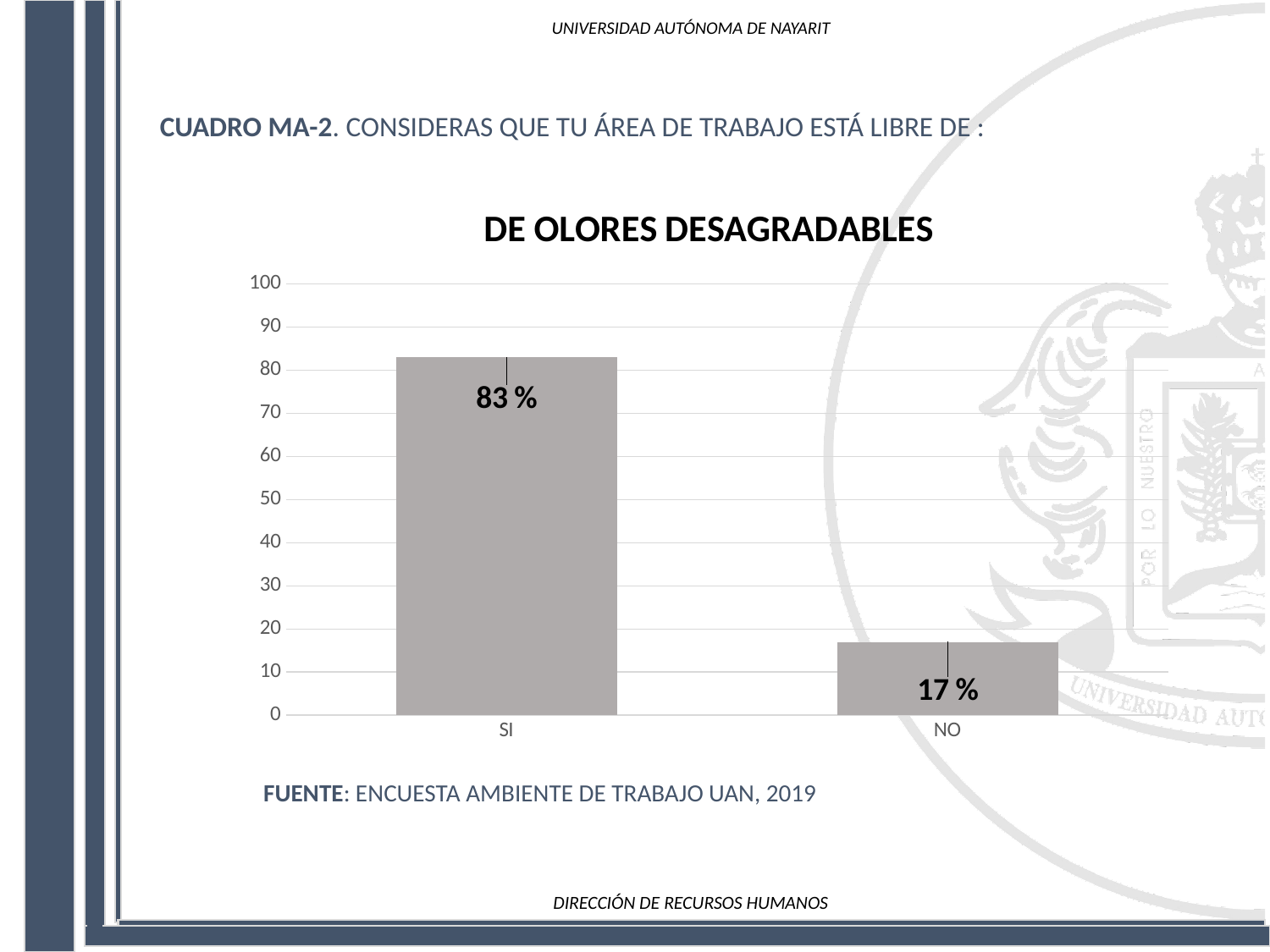
How many categories are shown on the x axis? 2 What is the source cited below the chart? ENCUESTA AMBIENTE DE TRABAJO UAN, 2019 What is the value for NO? 17 % What is the value for SI? 83 % Is the value for SI greater or less than 80? greater Which category has the lowest value? NO What is the title of the chart? DE OLORES DESAGRADABLES What is the difference between the values for SI and NO? 66 % Which is larger, the value for SI or the value for NO? SI Which category has the highest value? SI Is the value for NO greater or less than 20? less What kind of chart is shown? bar chart